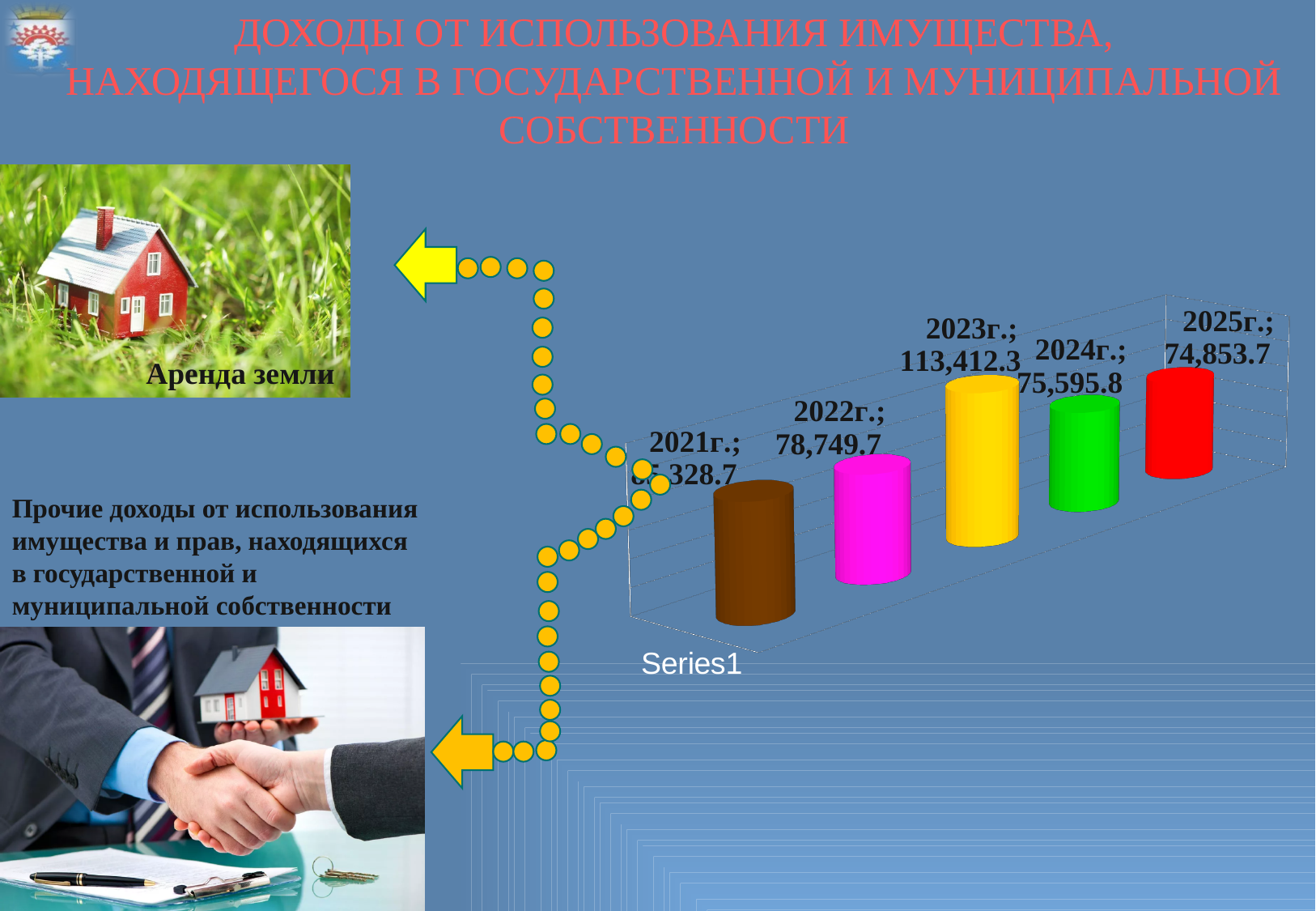
How many years (categories) are shown in the chart? 5 What is the value for 2024г. in the chart? 75,595.8 What is the value for 2025г. in the chart? 74,853.7 What is the value for 2023г. in the chart? 113,412.3 Which is larger, the value for 2022г. or the value for 2024г.? 2022г. Do the values rise or fall from 2023г. to 2025г.? Fall What is the difference between the values for 2023г. and 2022г.? 34,662.6 How many series does the chart legend list? 1 Which year has the highest value in the chart? 2023г. What is the difference between the values for 2024г. and 2025г.? 742.1 What is the value for 2022г. in the chart? 78,749.7 What kind of chart is shown on the slide? Bar chart